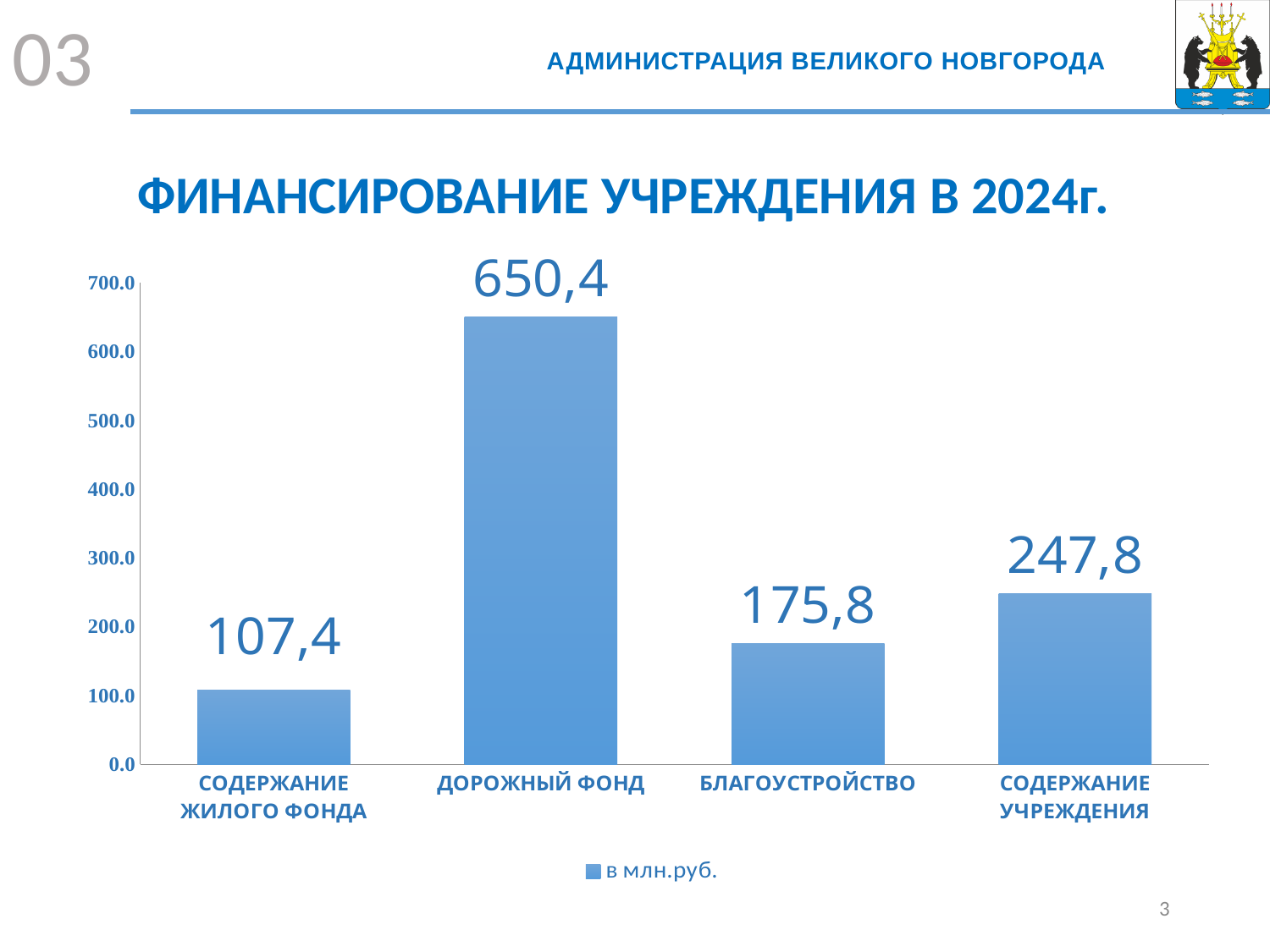
What is the value for БЛАГОУСТРОЙСТВО? 175,8 What is the difference between the values for ДОРОЖНЫЙ ФОНД and СОДЕРЖАНИЕ УЧРЕЖДЕНИЯ? 402,6 What unit does the legend give for the values? в млн.руб. What is the value for ДОРОЖНЫЙ ФОНД? 650,4 Which category has the highest value? ДОРОЖНЫЙ ФОНД What is the difference between the values for СОДЕРЖАНИЕ УЧРЕЖДЕНИЯ and БЛАГОУСТРОЙСТВО? 72,0 Which is larger, the value for БЛАГОУСТРОЙСТВО or the value for СОДЕРЖАНИЕ ЖИЛОГО ФОНДА? БЛАГОУСТРОЙСТВО What is the value for СОДЕРЖАНИЕ УЧРЕЖДЕНИЯ? 247,8 What kind of chart is shown on the slide? Bar chart How many categories are shown on the chart? 4 What is the value for СОДЕРЖАНИЕ ЖИЛОГО ФОНДА? 107,4 Which category has the lowest value? СОДЕРЖАНИЕ ЖИЛОГО ФОНДА